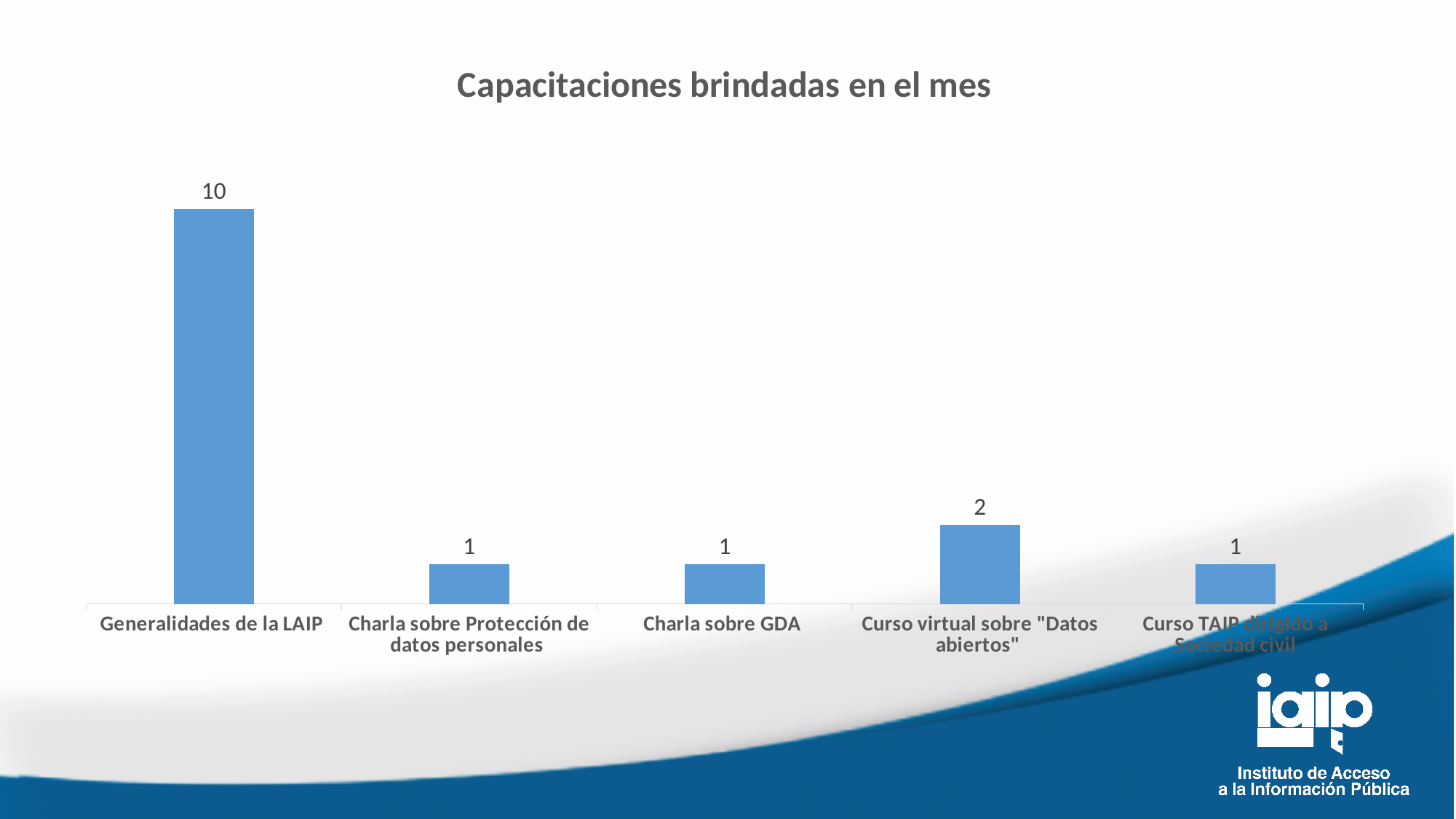
What is the value for Charla sobre Protección de datos personales? 1 What is the total of all the values shown in the chart? 15 How many categories are shown in the chart? 5 What kind of chart is this? Bar chart What is the value for Generalidades de la LAIP? 10 What is the title of the chart? Capacitaciones brindadas en el mes What is the difference between Curso virtual sobre "Datos abiertos" and Charla sobre GDA? 1 Which category has the highest value? Generalidades de la LAIP What is the value for Charla sobre GDA? 1 What is the difference between Generalidades de la LAIP and Curso virtual sobre "Datos abiertos"? 8 What is the value for Curso virtual sobre "Datos abiertos"? 2 Which is larger, Generalidades de la LAIP or Curso virtual sobre "Datos abiertos"? Generalidades de la LAIP